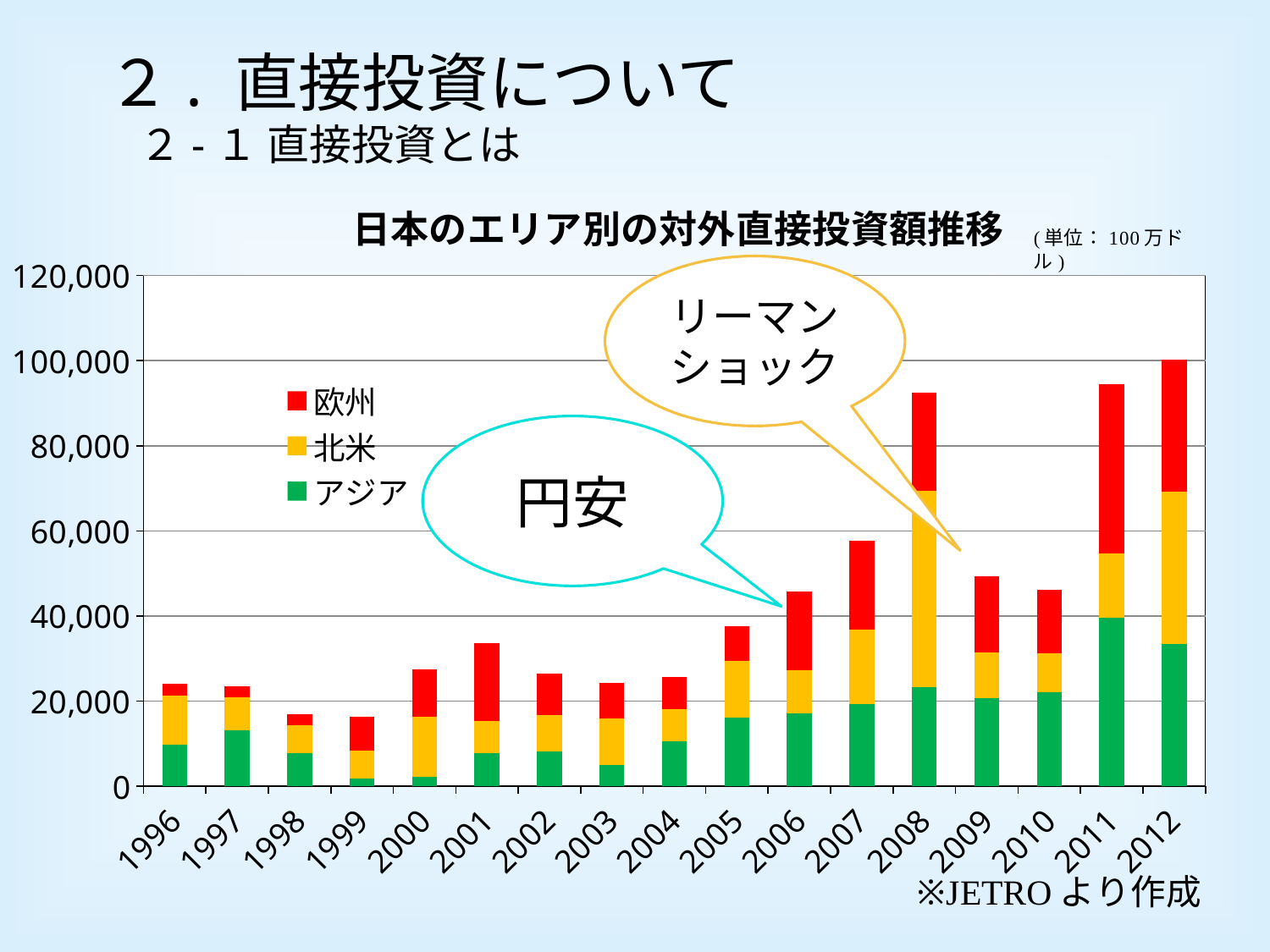
What kind of chart is shown on the slide? stacked bar chart Do the total values rise or fall from 2004 to 2008? rise Is the total value for 1999 greater or less than 20,000? less Which year has the highest total outward direct investment in the chart? 2012 Which series is shown in green in the chart? アジア Is the total value for 2012 greater or less than 80,000? greater What is the title of the chart? 日本のエリア別の対外直接投資額推移 How many series does the chart's legend list? 3 Which year has the larger total, 2008 or 2009? 2008 Is the total value for 2008 greater or less than 80,000? greater How many years are shown on the x axis of the chart? 17